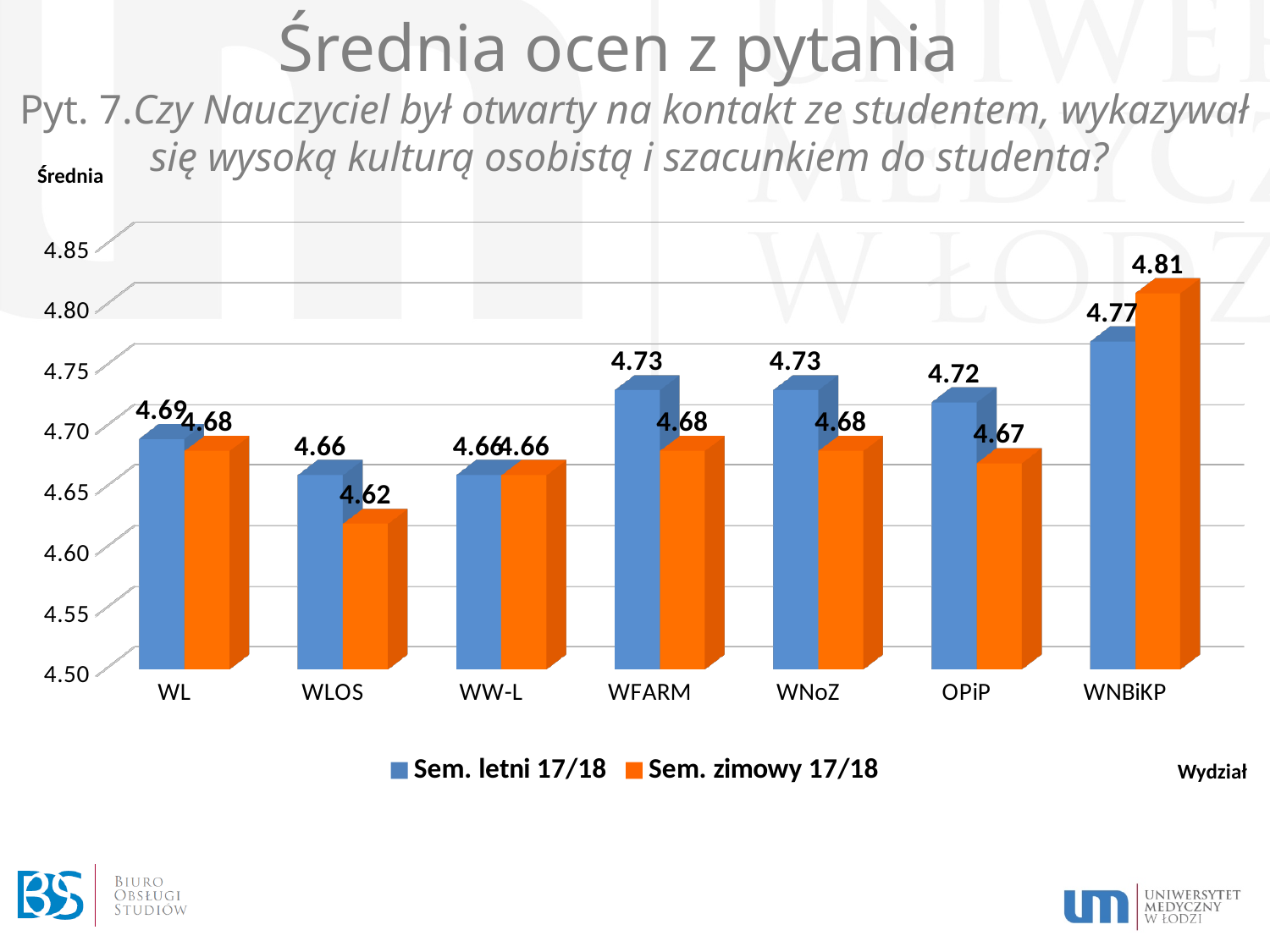
Which category has the highest value in the Sem. letni 17/18 series? WNBiKP What is the value for OPiP in the Sem. letni 17/18 series? 4.72 Which is larger for WNBiKP: the Sem. letni 17/18 value or the Sem. zimowy 17/18 value? Sem. zimowy 17/18 How many categories are shown on the x axis? 7 What is the difference between the Sem. letni 17/18 and Sem. zimowy 17/18 values for WLOS? 0.04 How many series does the legend list? 2 What kind of chart is shown on the slide? bar chart What is the value for WNBiKP in the Sem. zimowy 17/18 series? 4.81 What is the value for WLOS in the Sem. zimowy 17/18 series? 4.62 Is the Sem. letni 17/18 value for WFARM greater or less than 4.70? greater Which category has the lowest value in the Sem. zimowy 17/18 series? WLOS Which colour represents the Sem. zimowy 17/18 series? orange